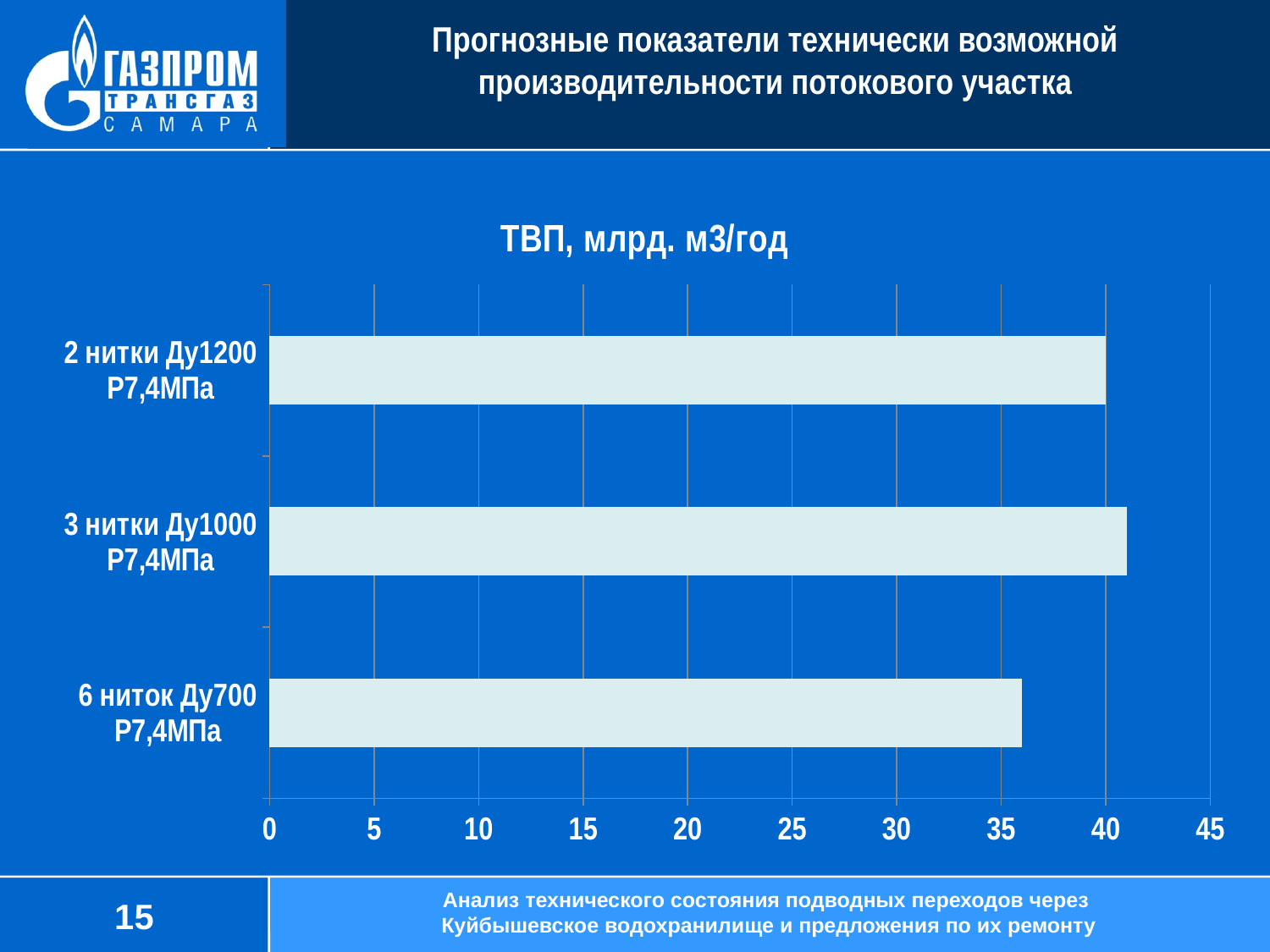
Is the value for 3 нитки Ду1000 Р7,4МПа greater or less than 40? greater Which category has the highest value? 3 нитки Ду1000 Р7,4МПа What is the title of the chart? ТВП, млрд. м3/год Is the value for 6 ниток Ду700 Р7,4МПа greater or less than 35? greater Is the value for 6 ниток Ду700 Р7,4МПа greater or less than 40? less What is the maximum value shown on the horizontal axis? 45 Which is larger, the value for 2 нитки Ду1200 Р7,4МПа or the value for 6 ниток Ду700 Р7,4МПа? 2 нитки Ду1200 Р7,4МПа What kind of chart is shown on the slide? bar chart How many categories are plotted in the chart? 3 Which is larger, the value for 3 нитки Ду1000 Р7,4МПа or the value for 6 ниток Ду700 Р7,4МПа? 3 нитки Ду1000 Р7,4МПа Which category has the lowest value? 6 ниток Ду700 Р7,4МПа